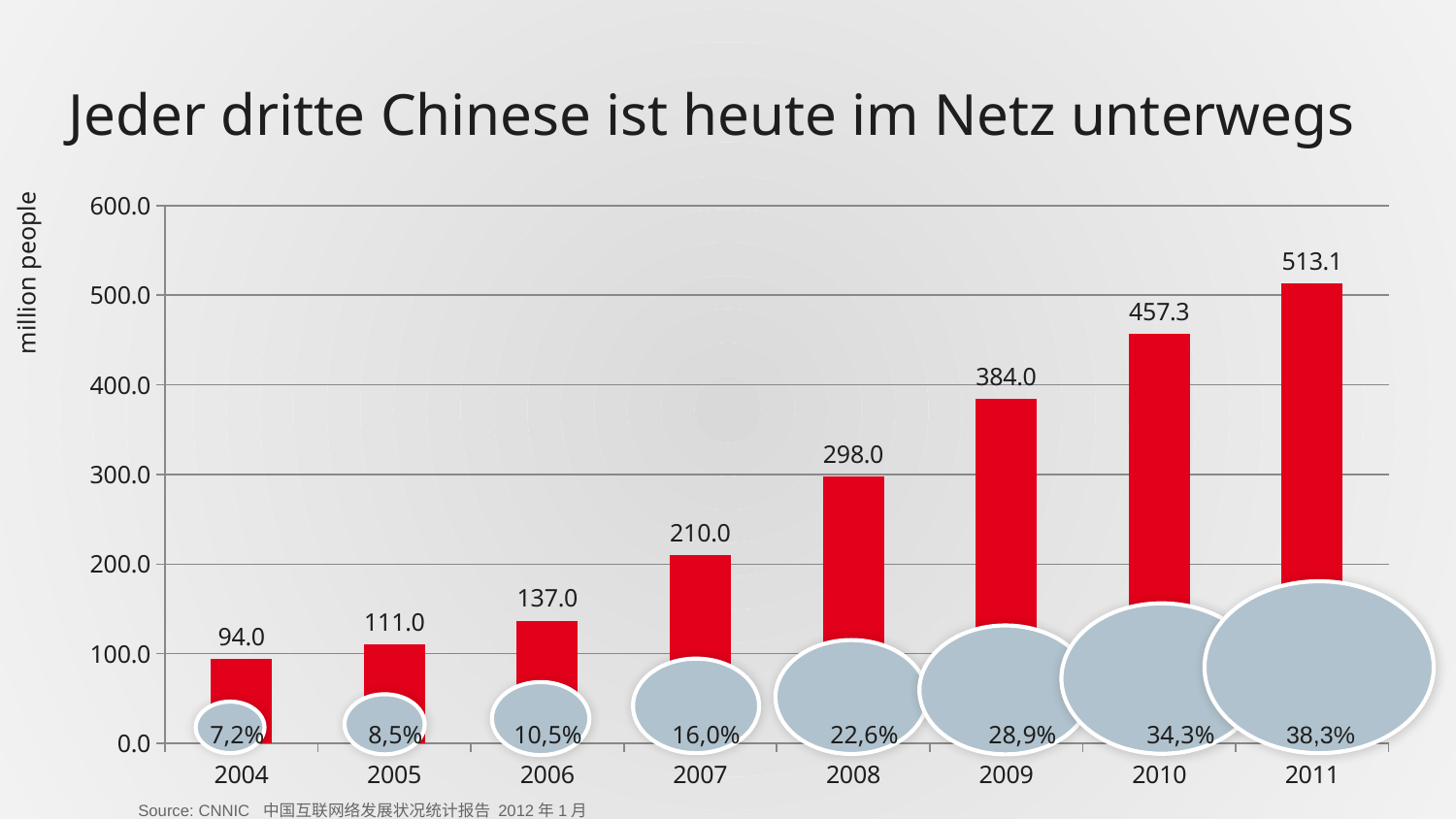
Do the values rise or fall from 2004 to 2011? rise What is the value for 2004 in million people? 94.0 Which is larger, the value for 2009 or the value for 2008? 2009 What is the difference in million people between 2007 and 2006? 73.0 What is the difference in million people between 2011 and 2010? 55.8 What is the value for 2008 in million people? 298.0 What kind of chart is this? bar chart What percentage is shown in the bubble for 2009? 28,9% Which year has the lowest value? 2004 Which year has the highest value? 2011 How many years are shown on the x axis? 8 Is the value for 2010 greater or less than 400.0? greater